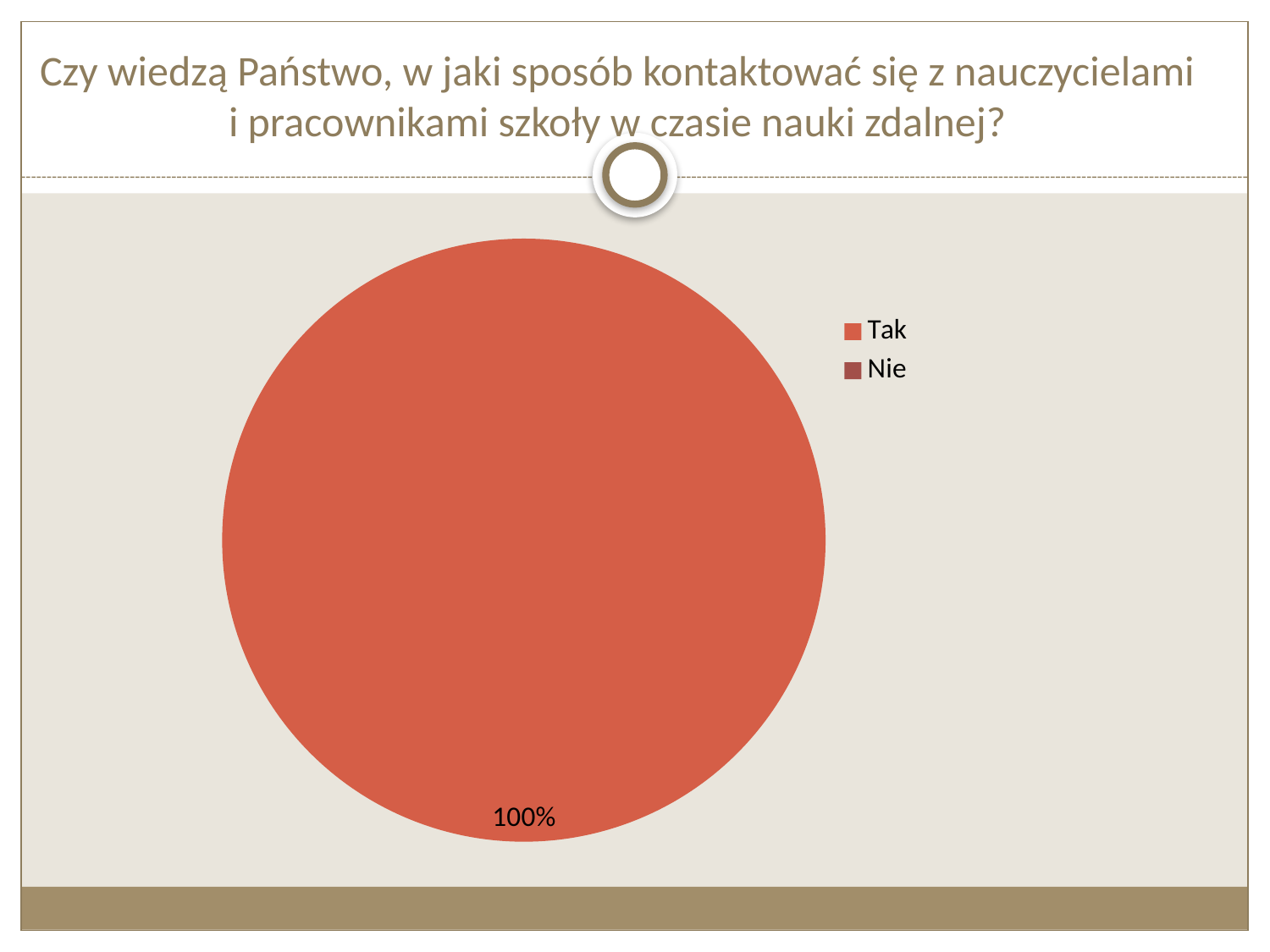
Which category has the smallest share of the pie? Nie What colour is the "Tak" slice? red-orange Which is larger, the share for "Tak" or the share for "Nie"? Tak What share of the pie does the "Tak" slice take? 100% What kind of chart is shown on the slide? pie chart What are the two legend entries? Tak, Nie What percentage label is printed on the pie? 100% Which category has the largest share of the pie? Tak How many entries does the legend list? 2